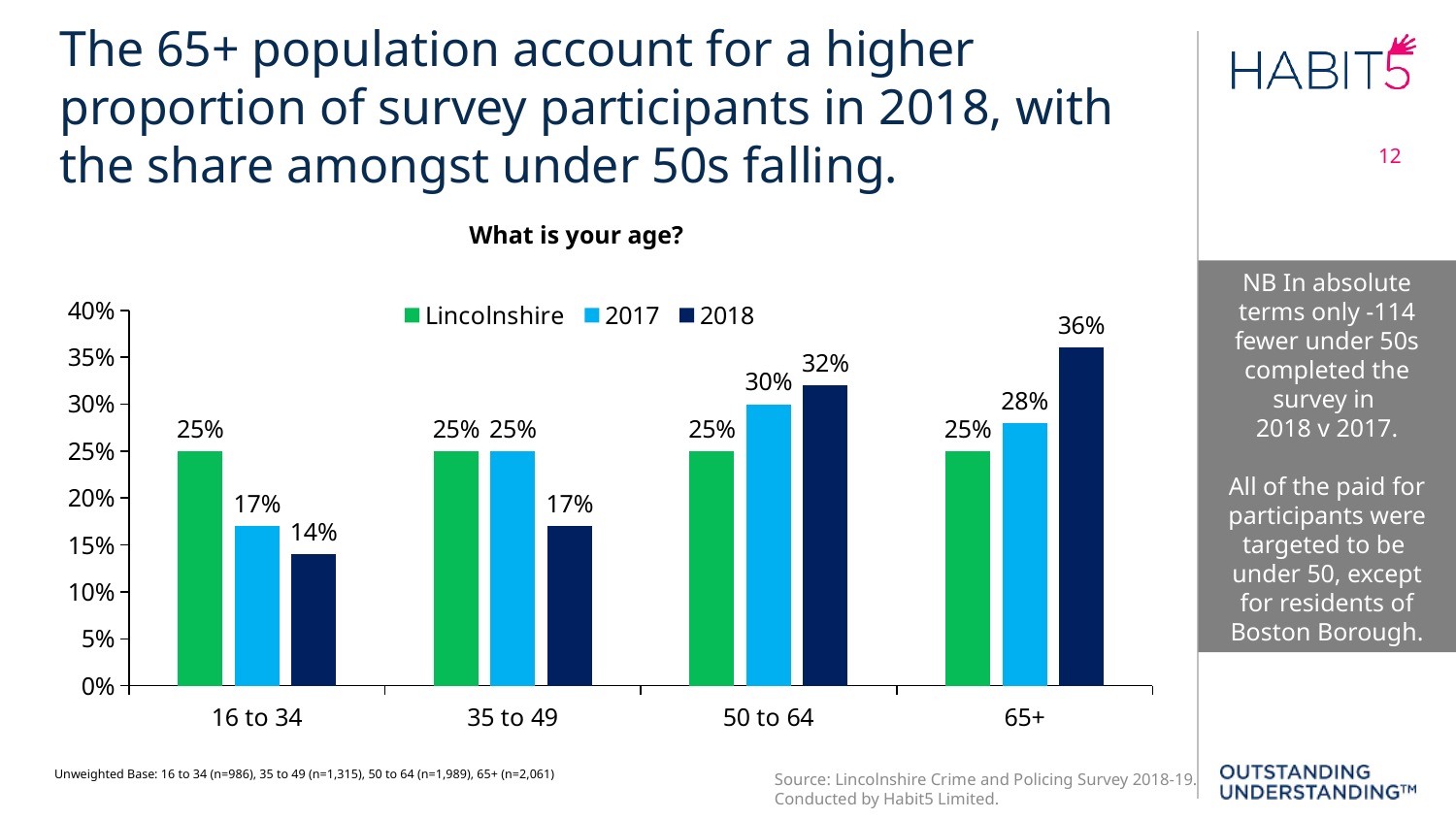
What is the Lincolnshire value for the 50 to 64 age group? 25% Which is larger for the 35 to 49 age group: the 2017 value or the 2018 value? 2017 How many series does the legend list? 3 Which age group has the highest 2018 value? 65+ What is the 2018 value for the 65+ age group? 36% Which age group has the lowest 2018 value? 16 to 34 Do the 2018 values rise or fall from the 16 to 34 group to the 65+ group? Rise What kind of chart is shown on the slide? Bar chart What is the 2017 value for the 16 to 34 age group? 17% What is the difference between the 2018 and 2017 values for the 65+ age group? 8% How many age groups are shown on the x axis? 4 What is the title of the chart? What is your age?